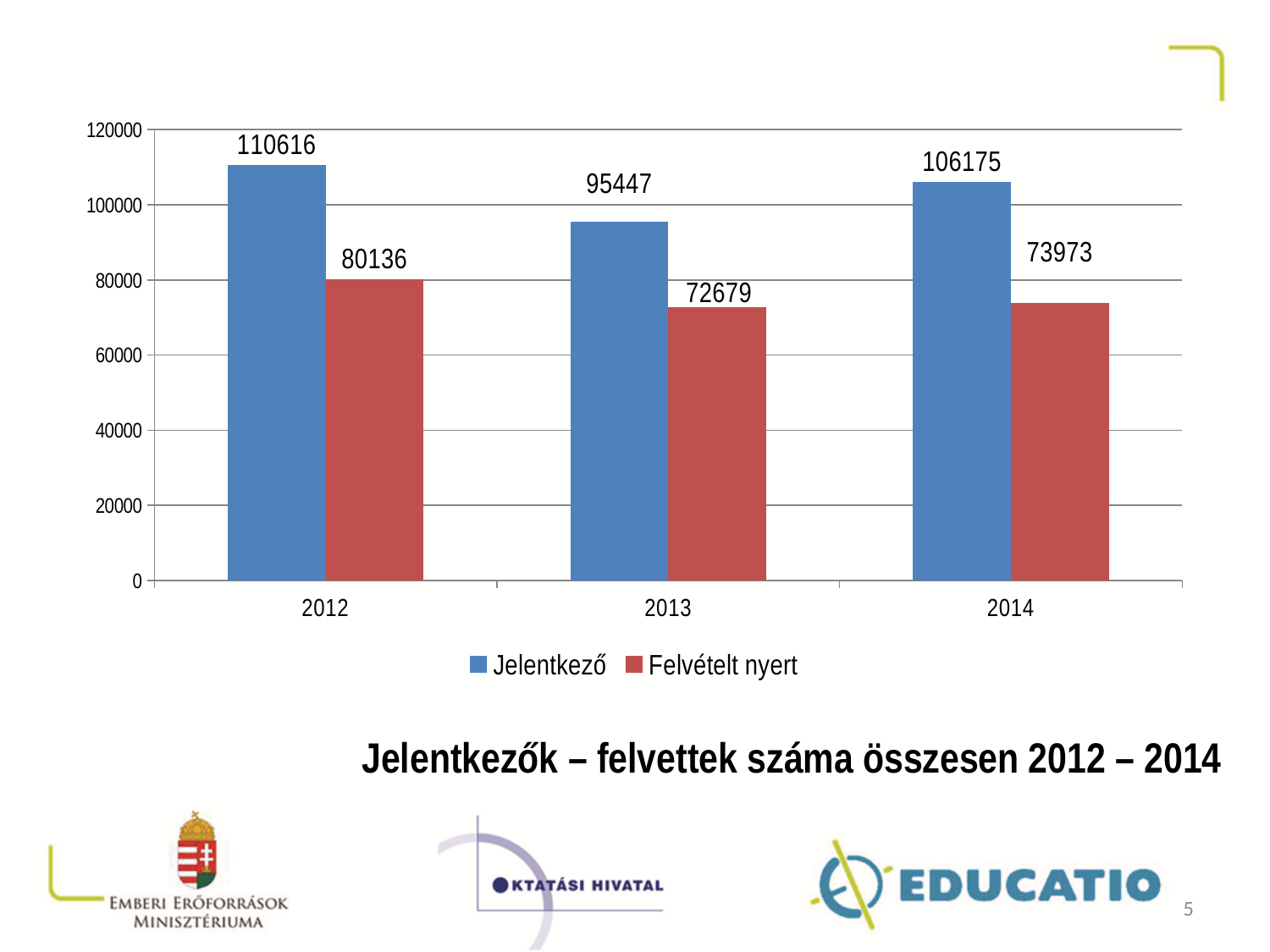
Is the value for Jelentkező in 2013 greater or less than 100000? less What is the value for Felvételt nyert in 2013? 72679 What is the difference between the Jelentkező values for 2012 and 2013? 15169 What kind of chart is shown on the slide? bar chart Which is larger, Felvételt nyert in 2012 or Felvételt nyert in 2014? Felvételt nyert in 2012 How many series does the legend list? 2 What is the difference between Jelentkező and Felvételt nyert in 2014? 32202 What is the value for Felvételt nyert in 2014? 73973 How many years are shown on the x axis? 3 What is the value for Jelentkező in 2012? 110616 Which year has the lowest value for Felvételt nyert? 2013 Which year has the highest value for Jelentkező? 2012